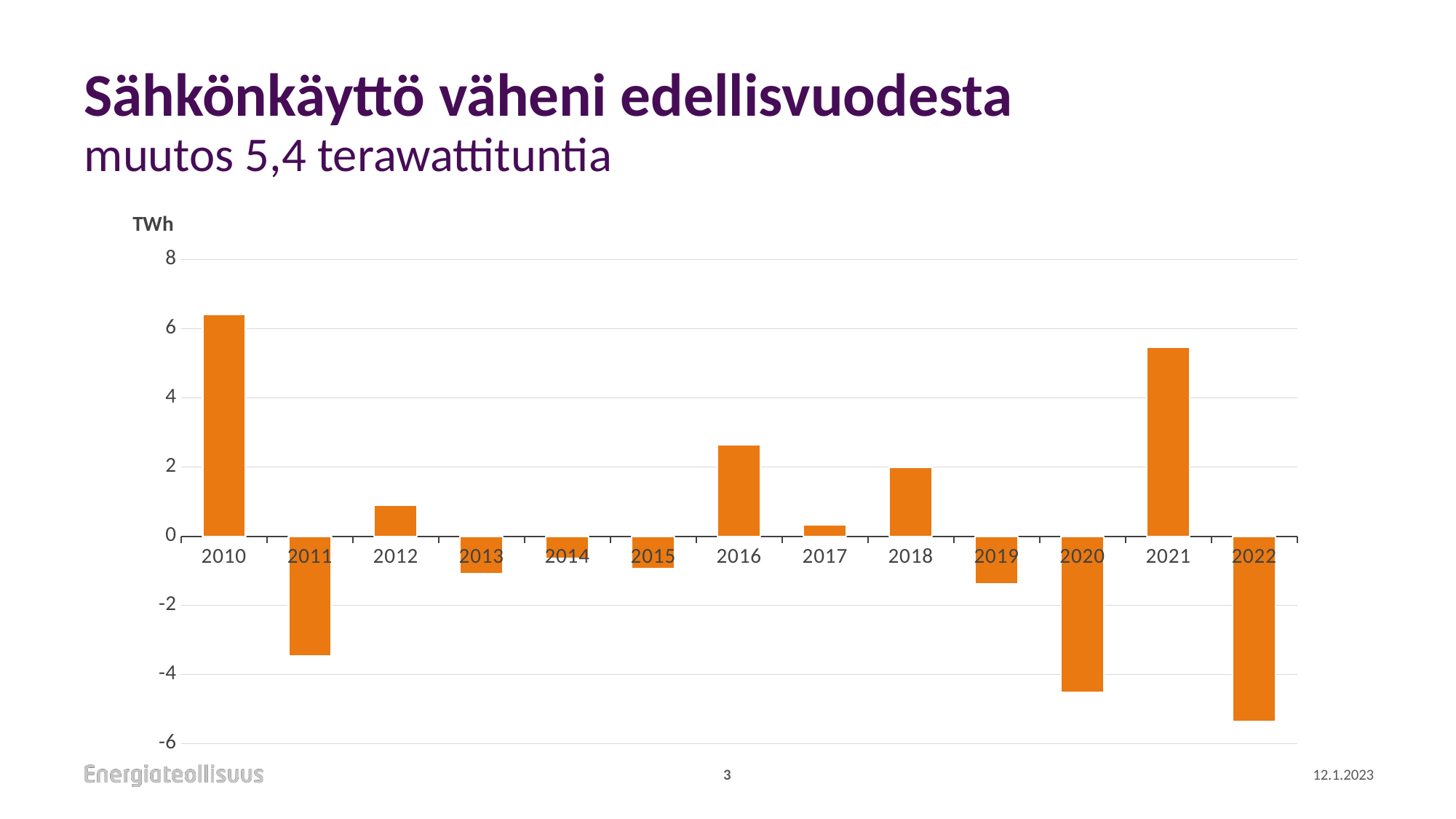
What kind of chart is shown on the slide? bar chart Which year has the lowest value in the chart? 2022 Which year has the larger value, 2016 or 2018? 2016 Is the value for 2021 greater or less than 4? greater How many years in the chart have a negative value? 7 How many years are shown on the x axis of the chart? 13 Is the value for 2010 greater or less than 6? greater What unit is shown on the vertical axis of the chart? TWh Is the value for 2020 greater or less than -4? less Which year has the highest value in the chart? 2010 Which year has the larger value, 2010 or 2021? 2010